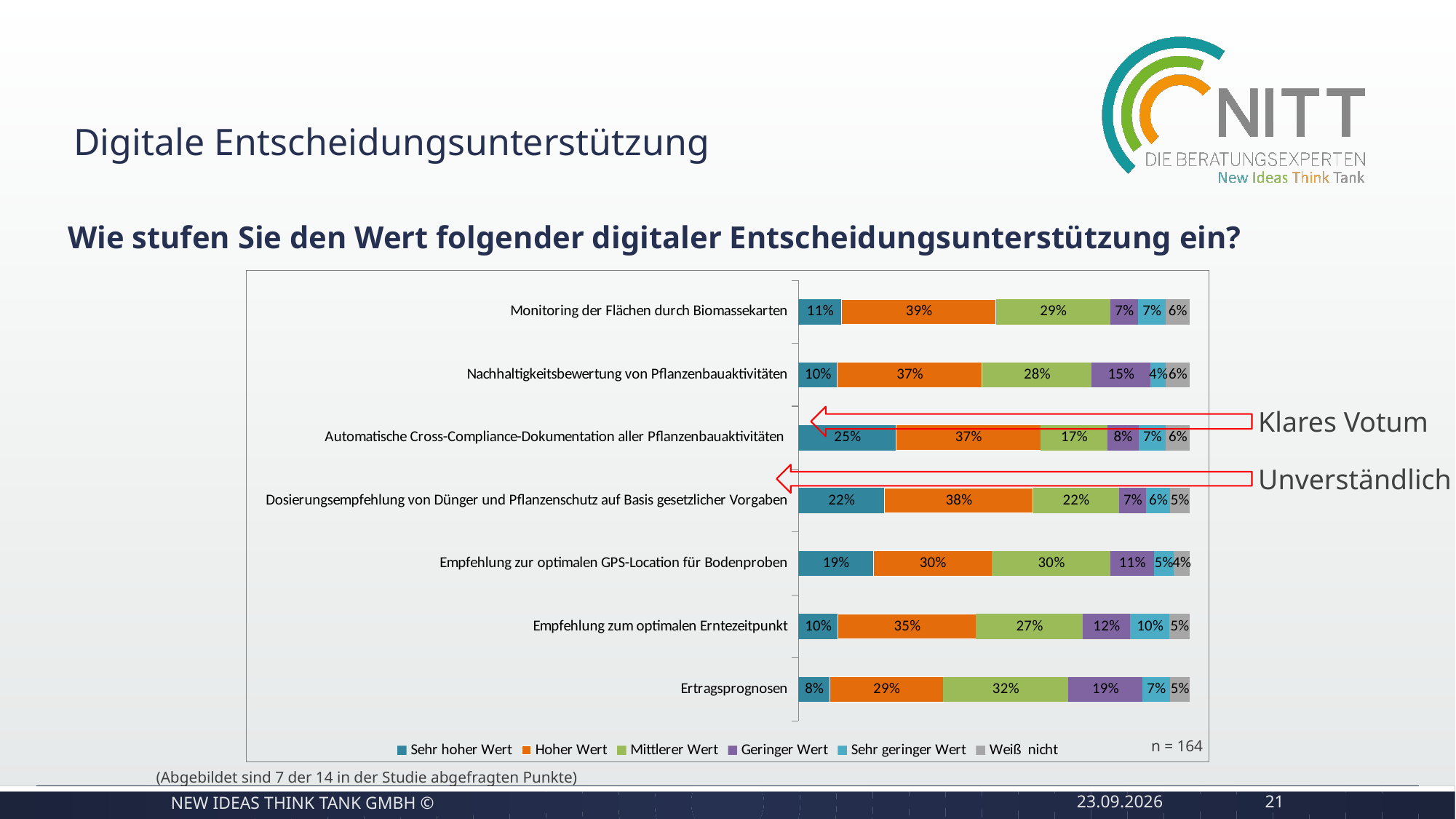
What is the difference between the 'Hoher Wert' shares of 'Monitoring der Flächen durch Biomassekarten' and 'Ertragsprognosen'? 10% What percentage of respondents rated 'Monitoring der Flächen durch Biomassekarten' as 'Hoher Wert'? 39% Which category has the highest 'Sehr hoher Wert' share? Automatische Cross-Compliance-Dokumentation aller Pflanzenbauaktivitäten Which category has the highest 'Mittlerer Wert' share? Ertragsprognosen How many series does the legend list? 6 Which has a larger 'Geringer Wert' share: 'Nachhaltigkeitsbewertung von Pflanzenbauaktivitäten' or 'Empfehlung zur optimalen GPS-Location für Bodenproben'? Nachhaltigkeitsbewertung von Pflanzenbauaktivitäten What kind of chart is shown on the slide? Stacked bar chart Which category has the lowest 'Sehr hoher Wert' share? Ertragsprognosen What is the 'Sehr hoher Wert' share for 'Automatische Cross-Compliance-Dokumentation aller Pflanzenbauaktivitäten'? 25% What is the 'Geringer Wert' share for 'Ertragsprognosen'? 19% How many categories are shown in the chart? 7 What is the 'Sehr geringer Wert' share for 'Empfehlung zum optimalen Erntezeitpunkt'? 10%